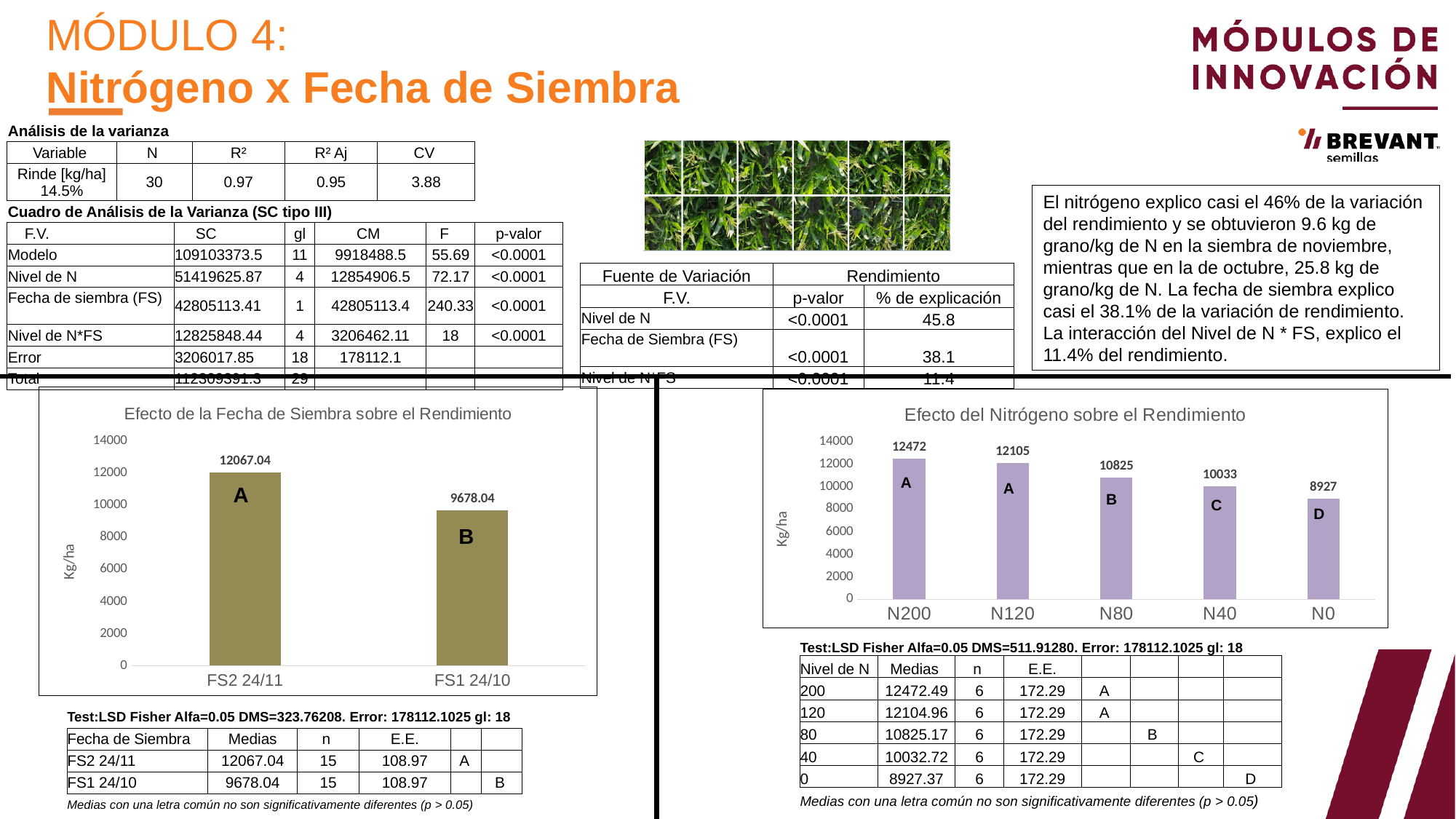
In the chart 'Efecto del Nitrógeno sobre el Rendimiento', which is larger, the value for N120 or the value for N80? N120 In the chart 'Efecto de la Fecha de Siembra sobre el Rendimiento', what is the difference between the values for FS2 24/11 and FS1 24/10? 2389 What kind of chart is 'Efecto del Nitrógeno sobre el Rendimiento'? bar chart In the chart 'Efecto del Nitrógeno sobre el Rendimiento', which category has the lowest value? N0 In the chart 'Efecto del Nitrógeno sobre el Rendimiento', which category has the highest value? N200 In the chart 'Efecto del Nitrógeno sobre el Rendimiento', what is the difference between the values for N200 and N0? 3545 In the chart 'Efecto del Nitrógeno sobre el Rendimiento', do the values rise or fall from N200 to N0 along the x axis? fall In the chart 'Efecto del Nitrógeno sobre el Rendimiento', what is the value for N40? 10033 In the chart 'Efecto del Nitrógeno sobre el Rendimiento', what is the value for N80? 10825 In the chart 'Efecto de la Fecha de Siembra sobre el Rendimiento', what is the value for FS1 24/10? 9678.04 In the chart 'Efecto de la Fecha de Siembra sobre el Rendimiento', what is the value for FS2 24/11? 12067.04 In the chart 'Efecto de la Fecha de Siembra sobre el Rendimiento', how many categories are plotted? 2